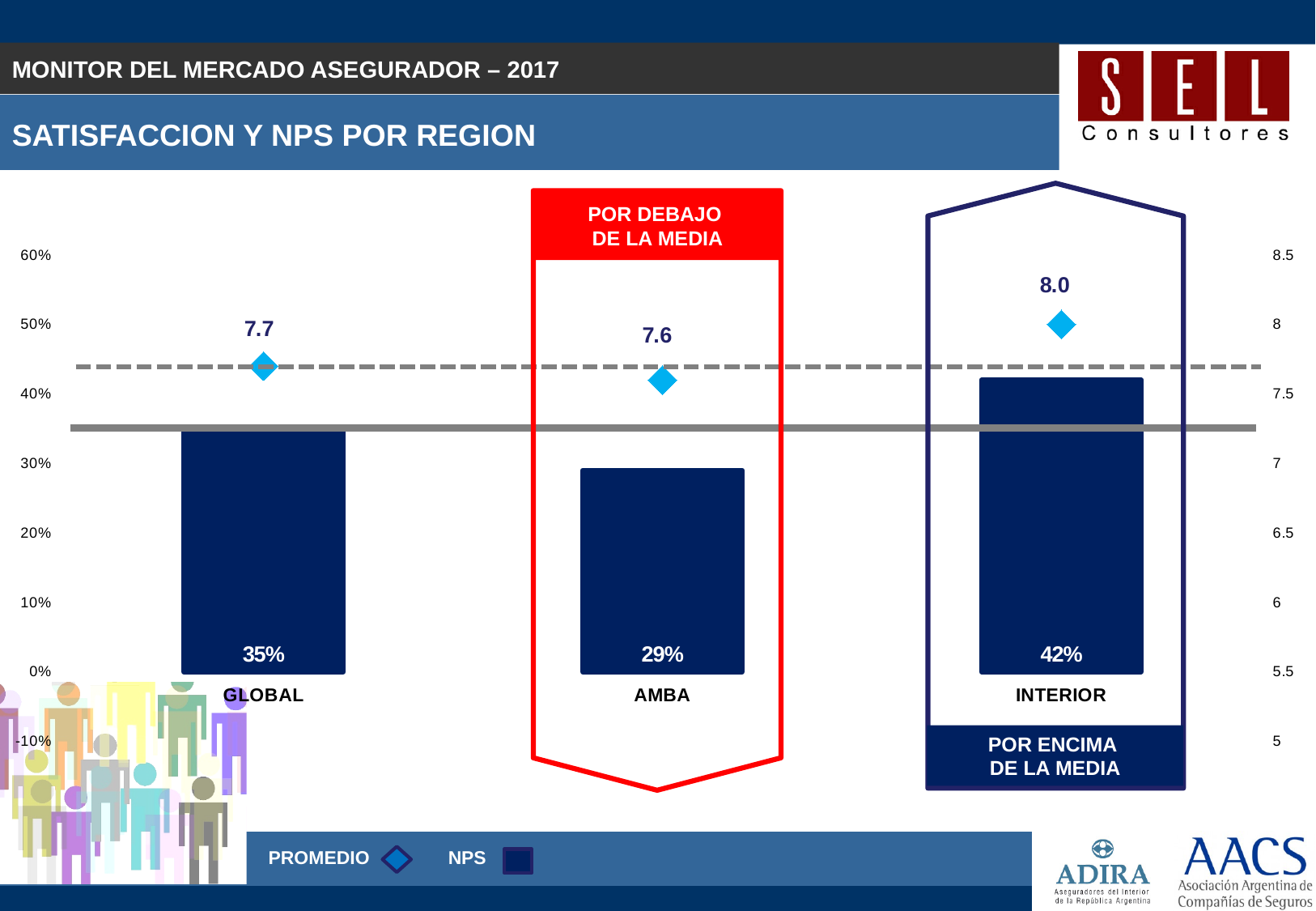
What is the PROMEDIO (average) value for GLOBAL? 7.7 What is the NPS value for INTERIOR? 42% Which region has the highest NPS? INTERIOR What is the difference between the NPS of INTERIOR and the NPS of AMBA? 13% Which region has the lowest PROMEDIO value? AMBA Which is larger, the NPS for GLOBAL or the NPS for AMBA? GLOBAL How many series does the legend list? 2 Which series is represented by the diamond markers according to the legend? PROMEDIO What is the PROMEDIO (average) value for INTERIOR? 8.0 How many regions are shown on the x axis of the chart? 3 What is the NPS value for AMBA? 29% What kind of chart is used to show the NPS values? Bar chart